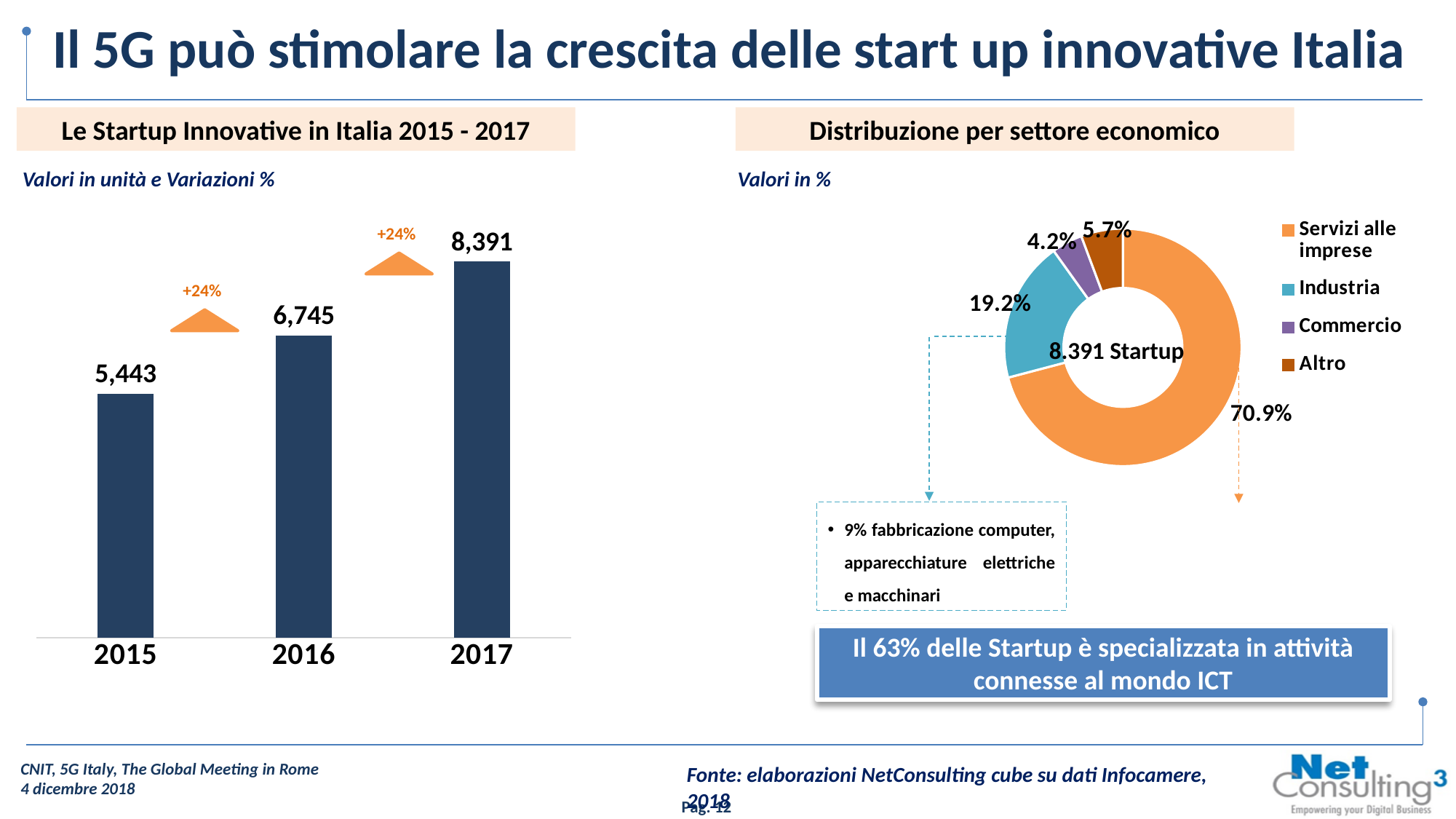
In the chart 'Le Startup Innovative in Italia 2015 - 2017', what is the value for 2017? 8,391 In the chart 'Distribuzione per settore economico', which sector has the largest share? Servizi alle imprese In the chart 'Le Startup Innovative in Italia 2015 - 2017', how many years are shown? 3 In the chart 'Le Startup Innovative in Italia 2015 - 2017', which year has the lowest value? 2015 In the chart 'Le Startup Innovative in Italia 2015 - 2017', what is the difference between the 2017 and 2015 values? 2,948 In the chart 'Le Startup Innovative in Italia 2015 - 2017', what is the value for 2016? 6,745 In the chart 'Distribuzione per settore economico', which is larger, Altro or Commercio? Altro In the chart 'Distribuzione per settore economico', what is the share for Industria? 19.2% In the chart 'Le Startup Innovative in Italia 2015 - 2017', do the values rise or fall from 2015 to 2017? rise What kind of chart is 'Le Startup Innovative in Italia 2015 - 2017'? bar chart How many entries does the legend of the chart 'Distribuzione per settore economico' list? 4 In the chart 'Distribuzione per settore economico', what is the share for Commercio? 4.2%